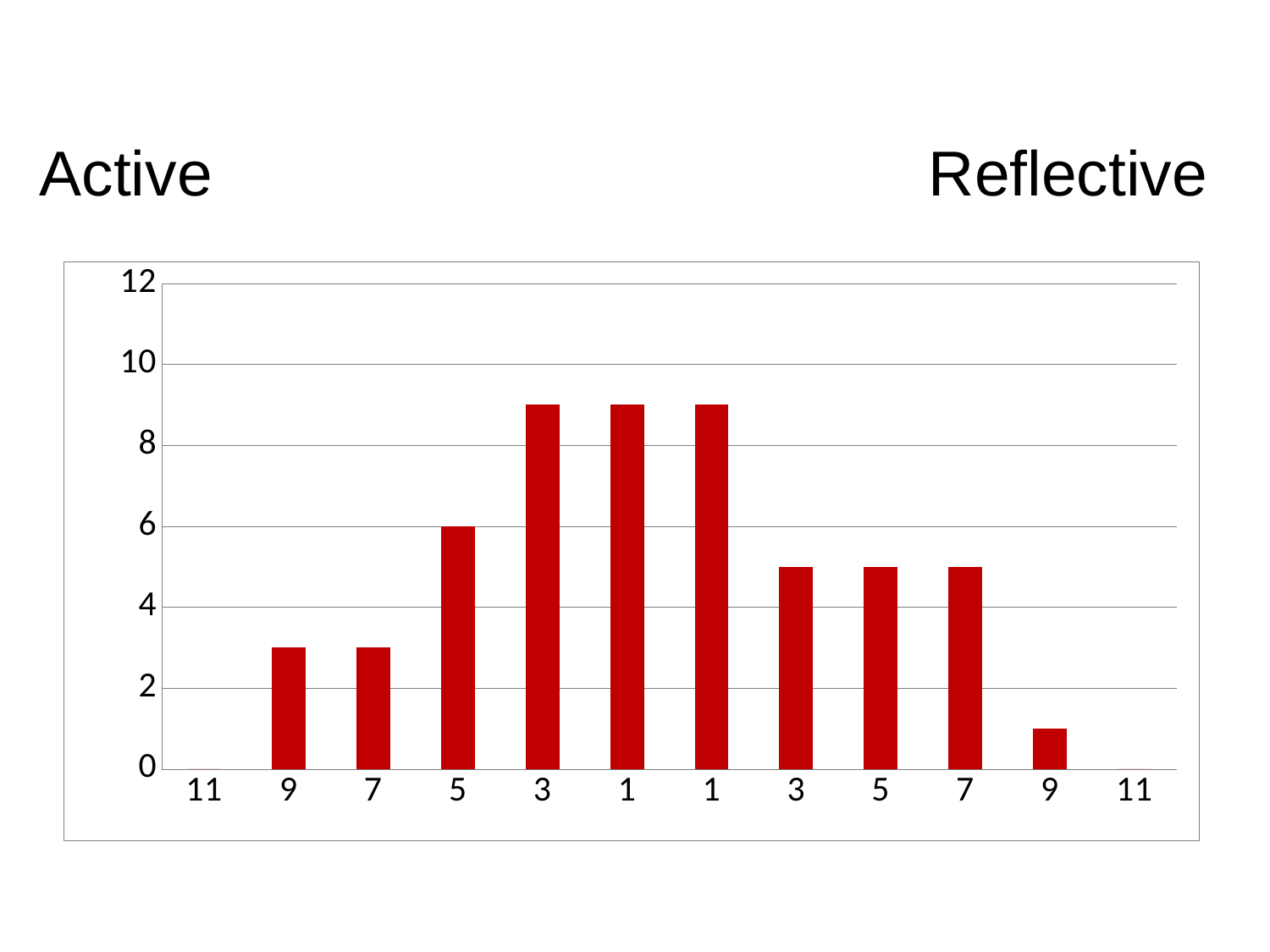
Which bar is taller: category 7 on the Active (left) side or category 7 on the Reflective (right) side? category 7 on the Reflective side What is the value of the bar at category 11 on the Reflective (right) side of the chart? 0 Is the value of the bar at category 3 on the Reflective (right) side greater or less than 6? less Is the value of the bar at category 3 on the Active (left) side greater or less than 8? greater What type of chart is shown on the slide? bar chart What two labels appear above the chart at the left and right? Active and Reflective How many categories are shown along the x axis of the chart? 12 Which bar is taller: category 9 on the Active (left) side or category 9 on the Reflective (right) side? category 9 on the Active side Is the value of the bar at category 9 on the Reflective (right) side greater or less than 2? less What is the value of the bar at category 5 on the Active (left) side of the chart? 6 Do the bar values rise or fall moving from category 11 to category 1 on the Active (left) side of the chart? rise